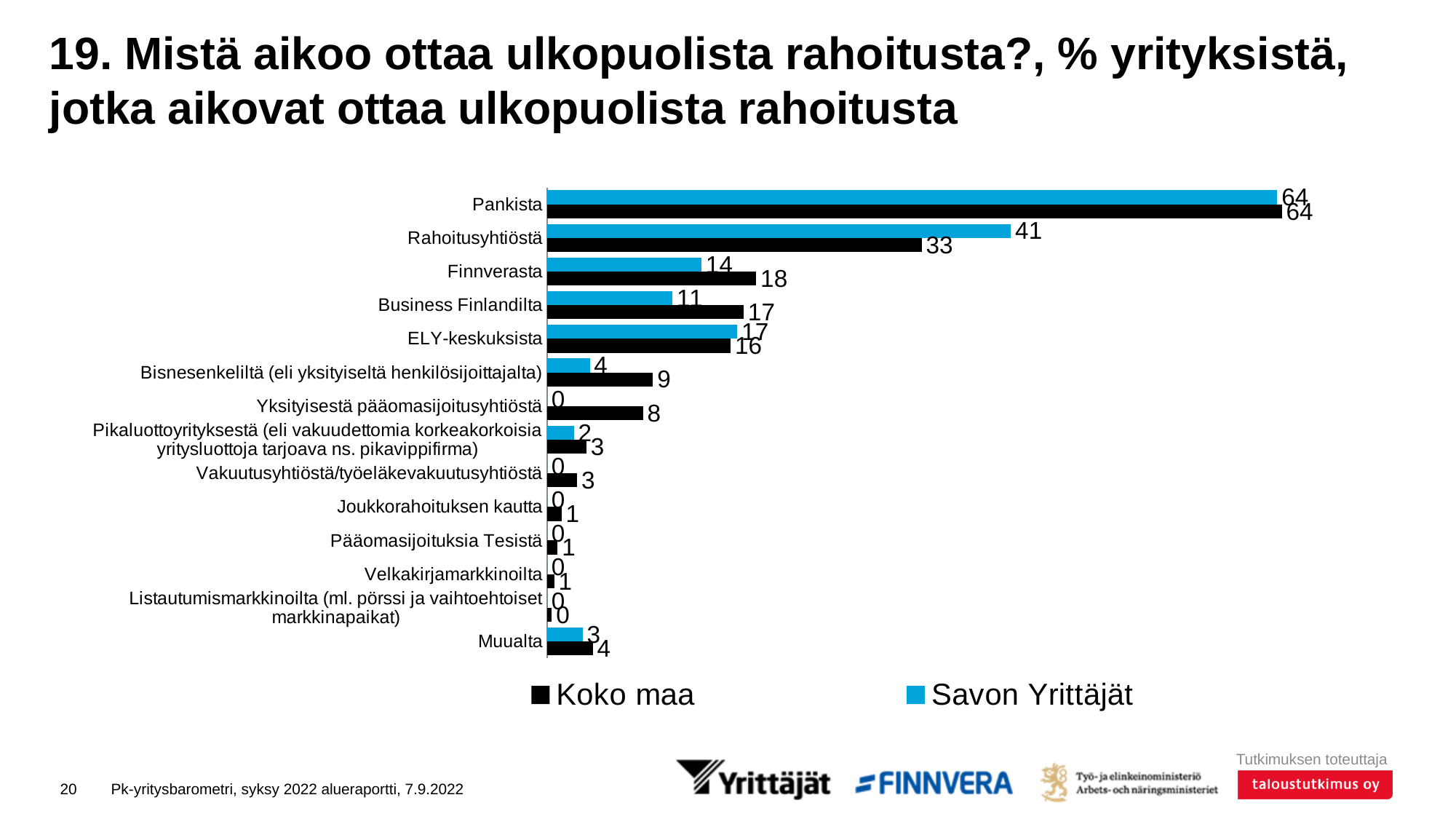
What is the value for Koko maa for Bisnesenkeliltä (eli yksityiseltä henkilösijoittajalta)? 9 What is the difference between the Koko maa and Savon Yrittäjät values for Business Finlandilta? 6 How many categories are shown on the chart? 14 How many series does the legend list? 2 Which category has the highest value for Koko maa? Pankista What is the value for Koko maa for Finnverasta? 18 What is the difference between the Savon Yrittäjät and Koko maa values for Rahoitusyhtiöstä? 8 For Finnverasta, which series has the larger value, Koko maa or Savon Yrittäjät? Koko maa What type of chart is shown on the slide? Bar chart For ELY-keskuksista, which series has the larger value, Koko maa or Savon Yrittäjät? Savon Yrittäjät What is the value for Savon Yrittäjät for Rahoitusyhtiöstä? 41 What is the value for Savon Yrittäjät for Business Finlandilta? 11